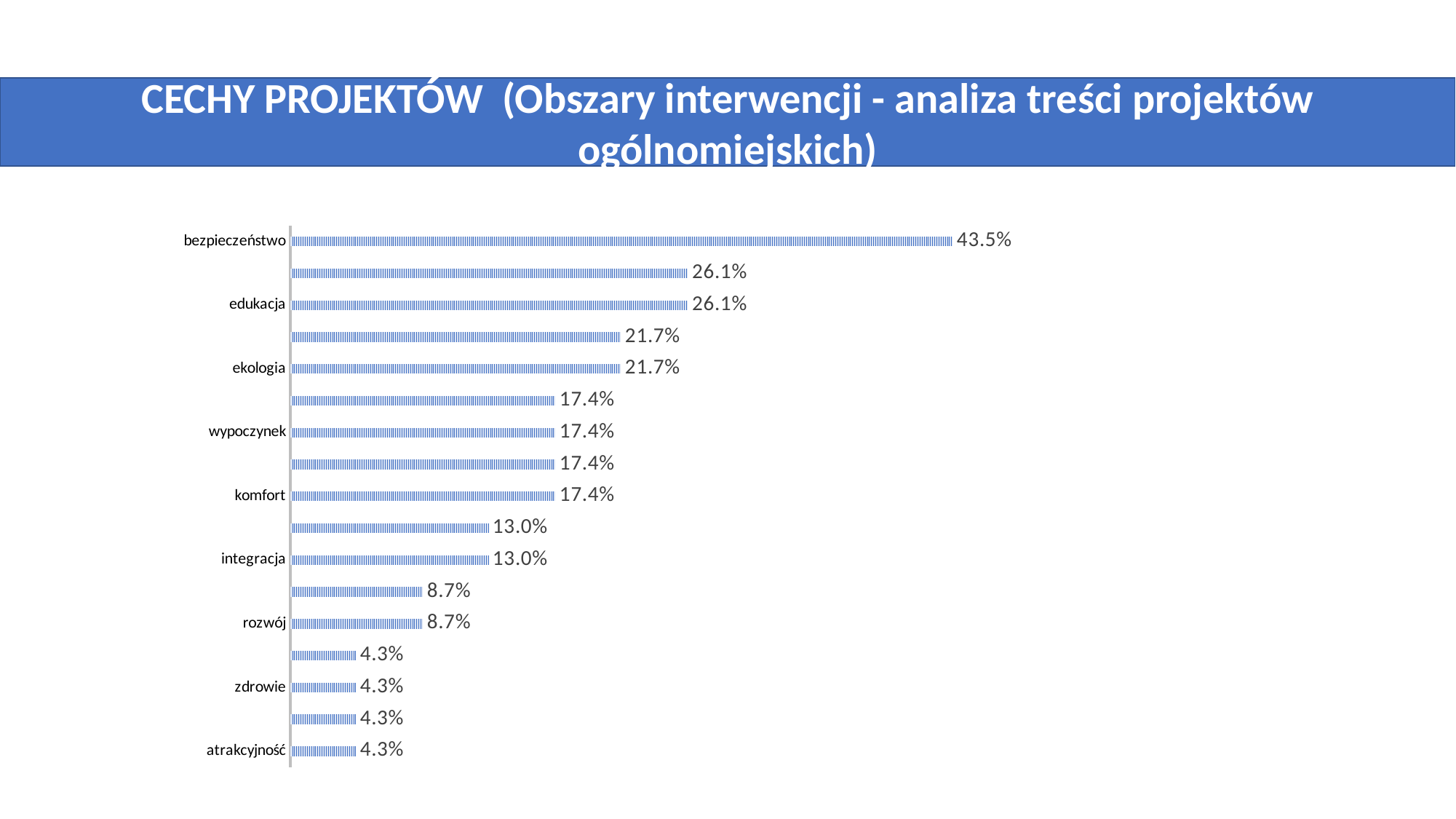
What type of chart is shown on the slide? bar chart What is the value for rozwój? 8.7% What is the difference between the values for bezpieczeństwo and edukacja? 17.4% What is the lowest value shown in the chart? 4.3% What is the value for bezpieczeństwo? 43.5% What is the value for atrakcyjność? 4.3% How many bars are plotted in the chart? 17 Which has a larger value, edukacja or ekologia? edukacja What is the value for integracja? 13.0% What is the value for edukacja? 26.1% What is the value for ekologia? 21.7% Which category has the highest value? bezpieczeństwo